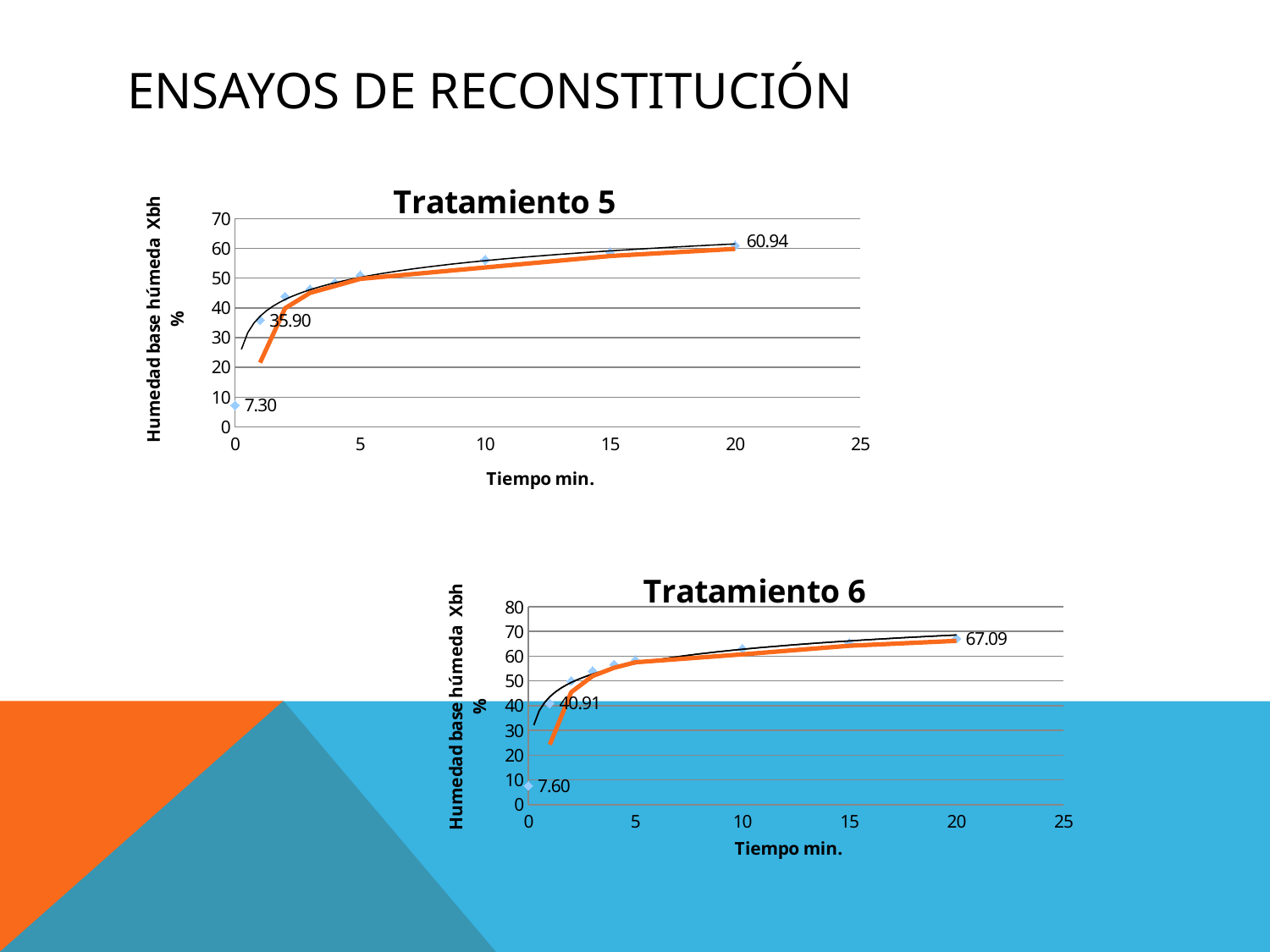
In the Tratamiento 6 chart, is the value at 10 minutes greater or less than 50? greater In the Tratamiento 6 chart, what is the labelled value at 20 minutes? 67.09 Which chart has the higher labelled value at 20 minutes, Tratamiento 5 or Tratamiento 6? Tratamiento 6 In the Tratamiento 5 chart, what is the difference between the value at 20 minutes and the value at time 0? 53.64 In the Tratamiento 5 chart, what is the labelled value at 20 minutes? 60.94 In the Tratamiento 5 chart, what is the labelled value at time 0? 7.30 In the Tratamiento 5 chart, what is the labelled value at 1 minute? 35.90 In the Tratamiento 6 chart, what is the labelled value at 1 minute? 40.91 In the Tratamiento 5 chart, do the values rise or fall as time increases? rise In the Tratamiento 6 chart, what is the labelled value at time 0? 7.60 What is the x-axis title of the Tratamiento 5 chart? Tiempo min. What kind of chart is the Tratamiento 6 chart? scatter chart